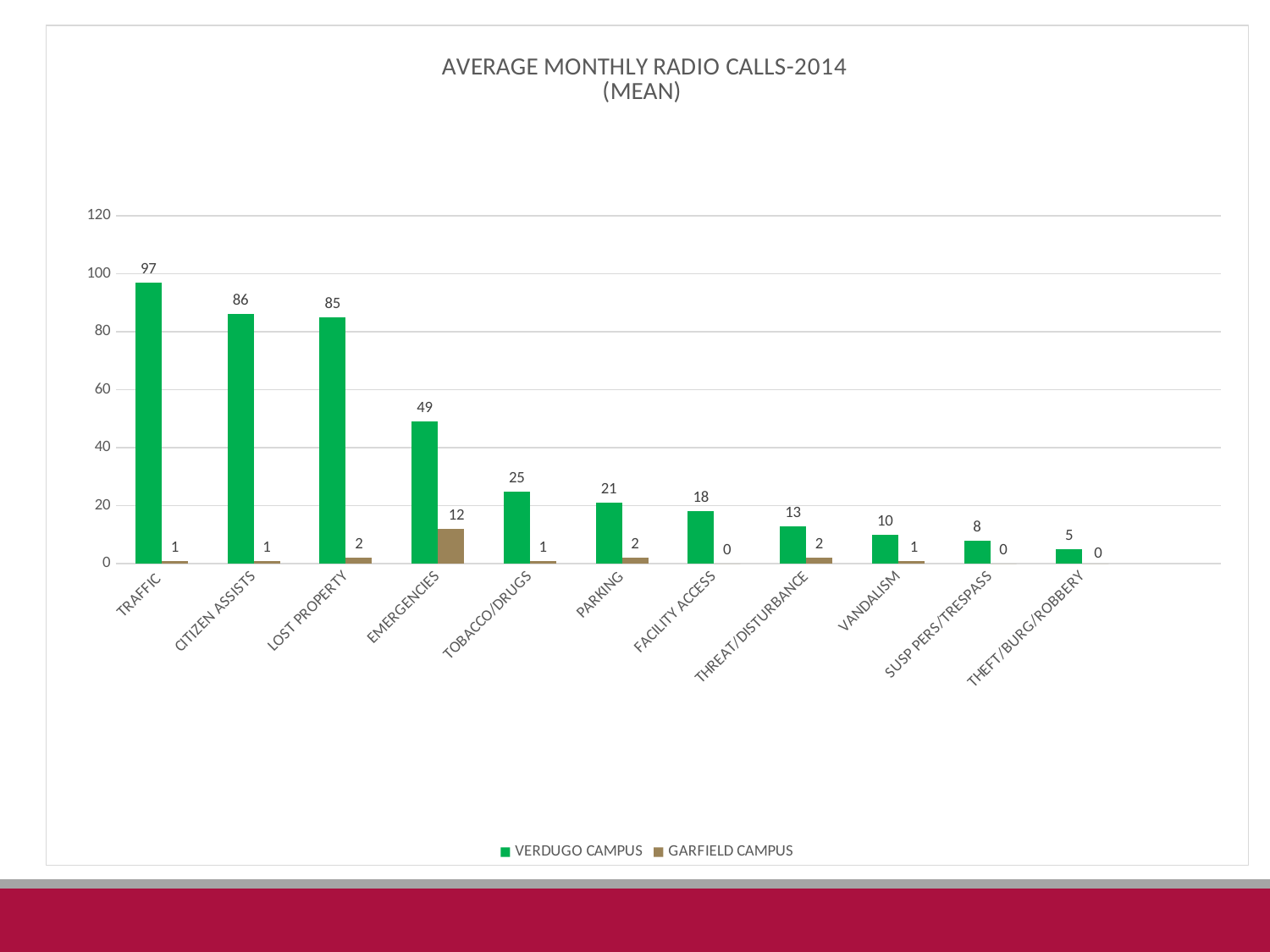
What is the value for GARFIELD CAMPUS in the EMERGENCIES category? 12 What is the value for VERDUGO CAMPUS in the THREAT/DISTURBANCE category? 13 How many series does the legend list? 2 Which is larger for VERDUGO CAMPUS: TOBACCO/DRUGS or PARKING? TOBACCO/DRUGS What is the difference between the VERDUGO CAMPUS and GARFIELD CAMPUS values for EMERGENCIES? 37 Which category has the highest value for VERDUGO CAMPUS? TRAFFIC How many categories are shown on the x axis? 11 What is the difference between the VERDUGO CAMPUS values for CITIZEN ASSISTS and LOST PROPERTY? 1 Is the VERDUGO CAMPUS value for EMERGENCIES greater or less than 40? greater What kind of chart is shown on the slide? Bar chart Which category has the lowest value for VERDUGO CAMPUS? THEFT/BURG/ROBBERY What is the value for VERDUGO CAMPUS in the TRAFFIC category? 97